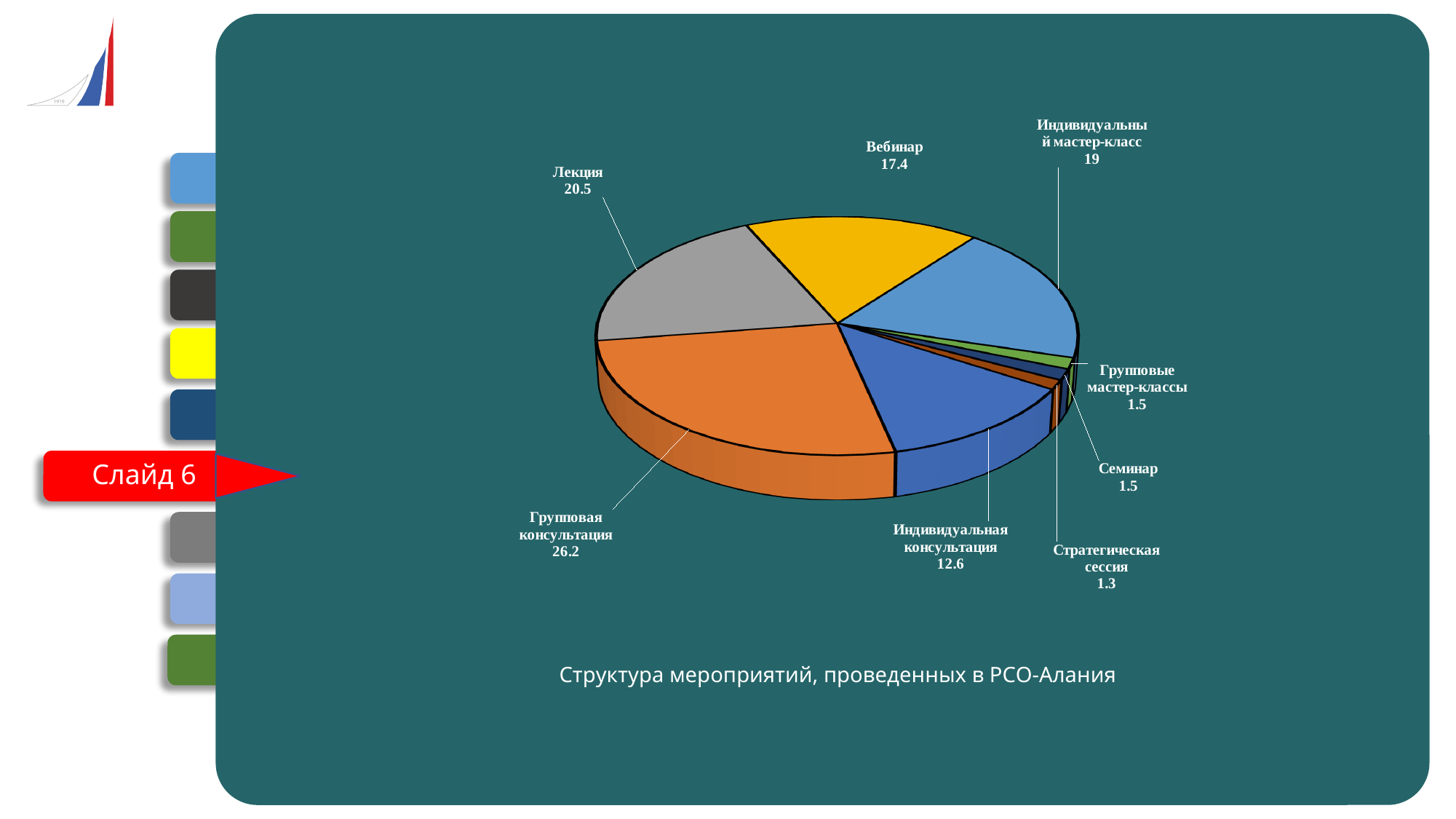
Which category has the largest slice of the pie? Групповая консультация What kind of chart is shown on the slide? Pie chart What value is shown for Групповая консультация? 26.2 How many categories are shown in the pie chart? 8 What is the difference between the values for Индивидуальный мастер-класс and Индивидуальная консультация? 6.4 What is the title of the chart? Структура мероприятий, проведенных в РСО-Алания What is the difference between the values for Групповая консультация and Лекция? 5.7 Which category has the smallest slice of the pie? Стратегическая сессия Which is larger, the value for Лекция or the value for Вебинар? Лекция What value is shown for Вебинар? 17.4 What value is shown for Стратегическая сессия? 1.3 What value is shown for Индивидуальный мастер-класс? 19